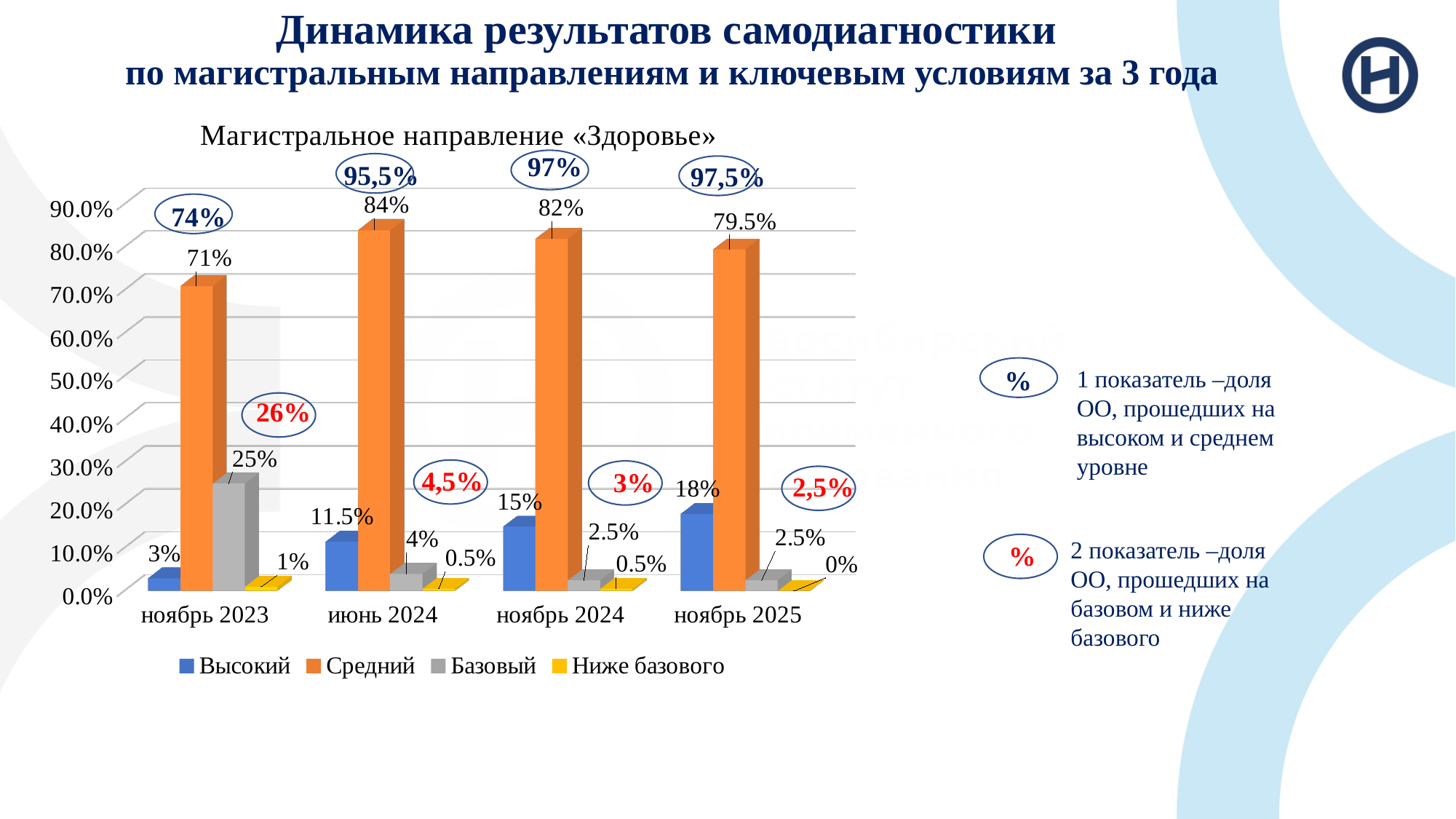
What is the value for Базовый in июнь 2024? 4% What is the difference between the Высокий values for ноябрь 2025 and ноябрь 2024? 3% Does the Высокий value rise or fall across the categories from ноябрь 2023 to ноябрь 2025? rise Which is larger: the Базовый value in ноябрь 2023 or the Высокий value in ноябрь 2023? Базовый What is the value for Ниже базового in ноябрь 2025? 0% How many series does the legend list? 4 In which category is the Высокий value lowest? ноябрь 2023 How many categories are shown on the x axis? 4 What type of chart is shown on the slide? bar chart In which category is the Средний value highest? июнь 2024 What is the value for Средний in ноябрь 2023? 71% What is the value for Высокий in ноябрь 2025? 18%